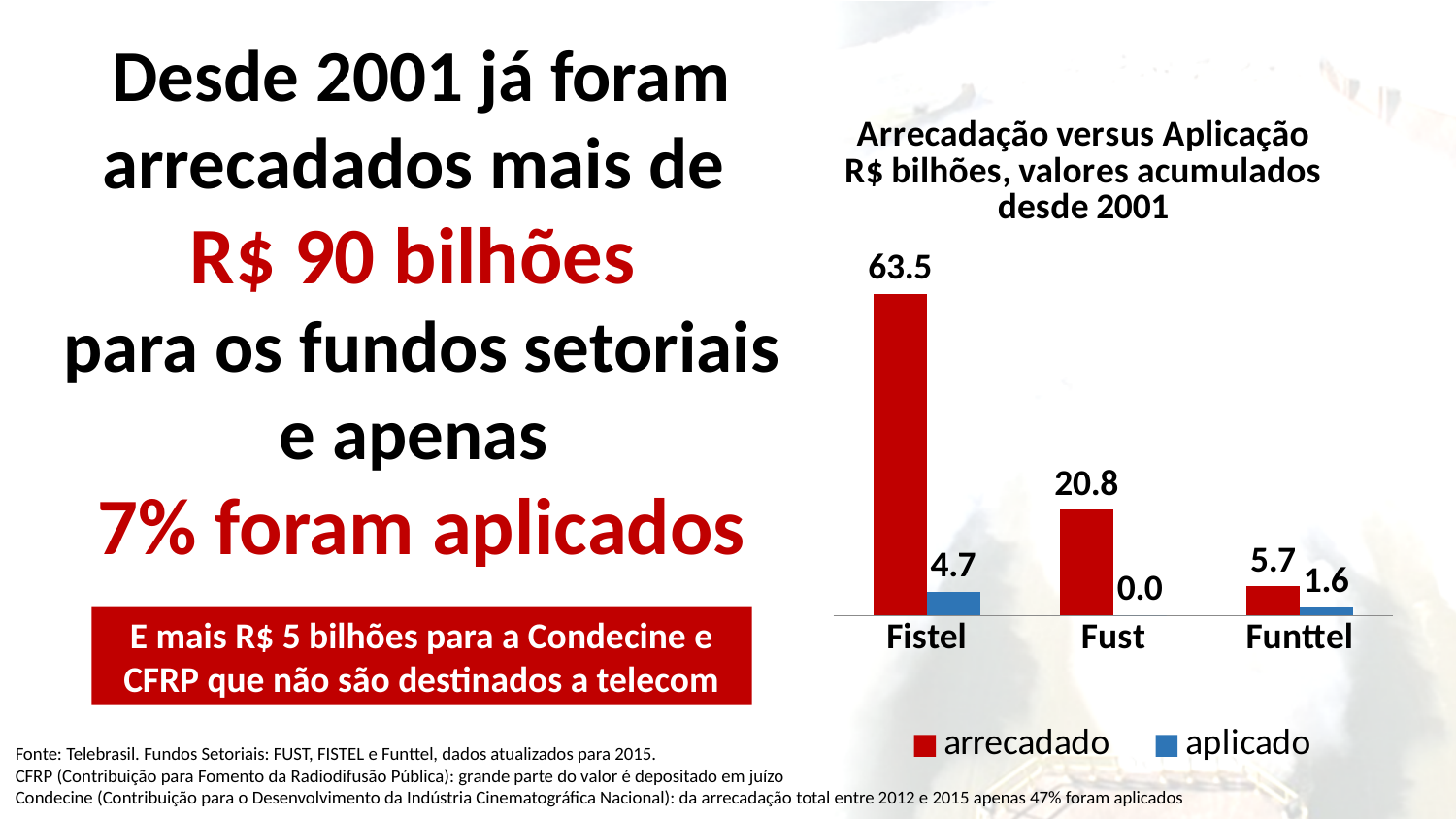
What is the 'aplicado' value for Fust? 0.0 What is the difference between the 'arrecadado' and 'aplicado' values for Fistel? 58.8 What is the 'arrecadado' value for Fust? 20.8 What is the 'aplicado' value for Funttel? 1.6 How many categories are shown on the x axis? 3 What kind of chart is shown? bar chart Which category has the highest 'arrecadado' value? Fistel What is the difference between the 'arrecadado' values for Fistel and Fust? 42.7 What is the 'arrecadado' value for Fistel? 63.5 How many series does the legend list? 2 Which category has the lowest 'aplicado' value? Fust Which is larger, the 'aplicado' value for Fistel or the 'aplicado' value for Funttel? Fistel